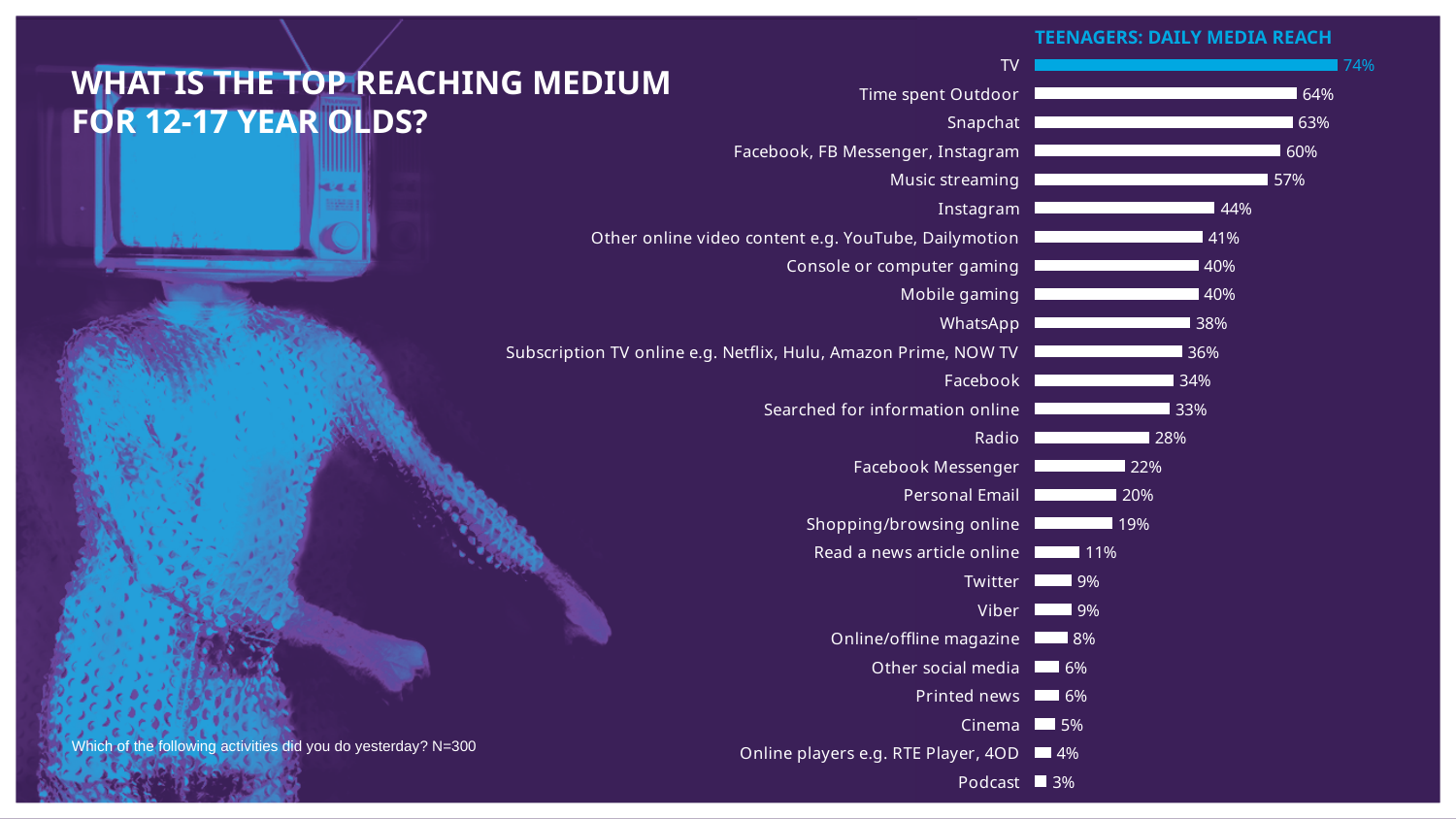
What is the daily reach value for TV? 74% Which medium has the lowest daily reach? Podcast What type of chart is used to show teenagers' daily media reach? Bar chart What is the daily reach value for Music streaming? 57% What is the daily reach value for Cinema? 5% What is the daily reach value for Radio? 28% What is the difference between the daily reach of Instagram and Facebook Messenger? 22% What is the title of the chart? TEENAGERS: DAILY MEDIA REACH What is the difference between the daily reach of Snapchat and Facebook? 29% Which has a higher daily reach, WhatsApp or Twitter? WhatsApp How many media categories are shown in the chart? 26 Which medium has the highest daily reach? TV